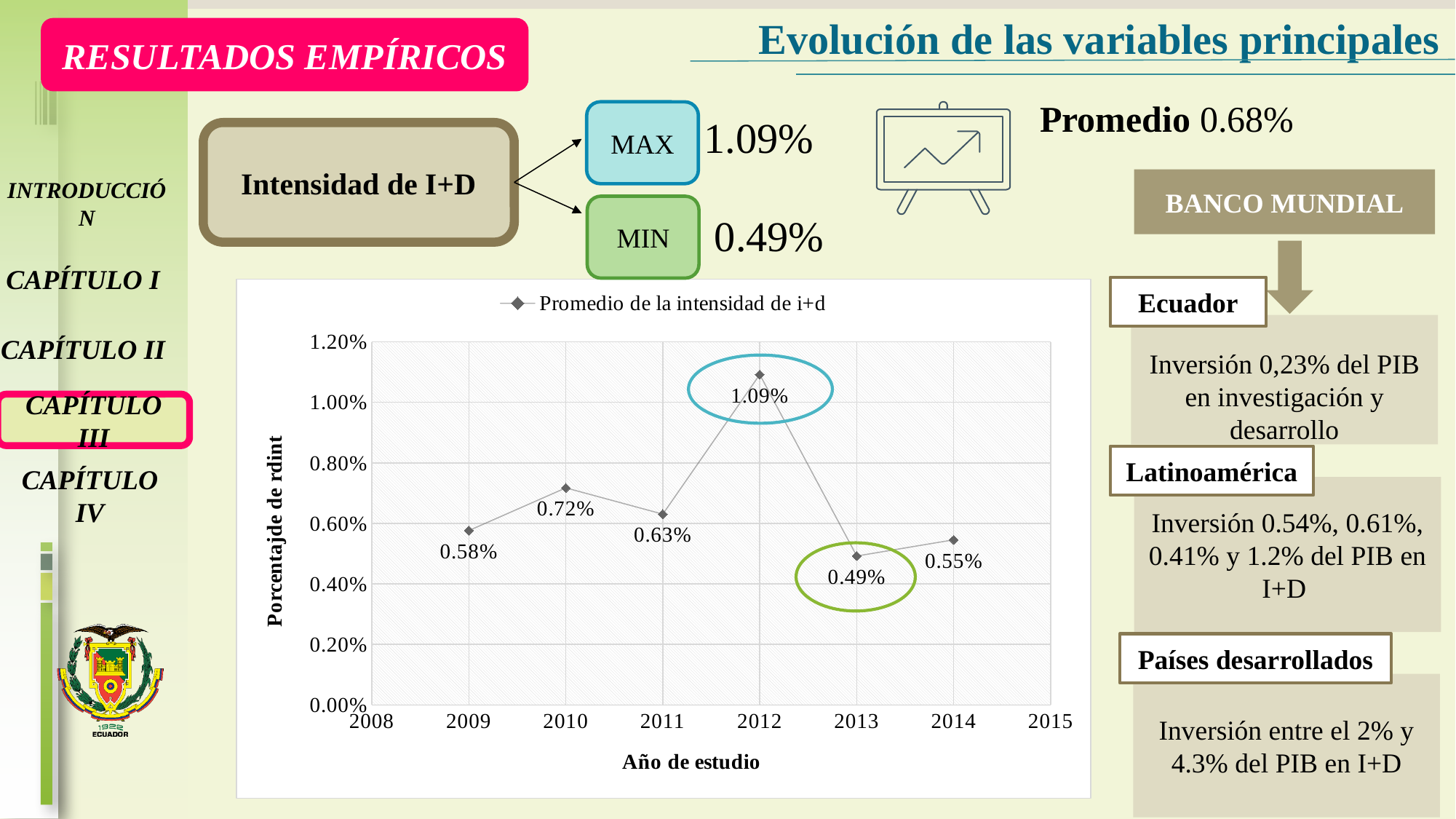
What is the value for 2012 in the chart? 1.09% What is the value for 2013 in the chart? 0.49% What is the difference between the values for 2010 and 2009? 0.14% What is the value for 2009 in the chart? 0.58% What kind of chart is shown on the slide? line chart Which year has the highest value in the chart? 2012 Which is larger, the value for 2010 or the value for 2011? 2010 How many data points are plotted in the chart? 6 What is the difference between the values for 2012 and 2013? 0.60% What is the legend entry of the series in the chart? Promedio de la intensidad de i+d Is the value for 2014 greater or less than 0.60%? less Which year has the lowest value in the chart? 2013